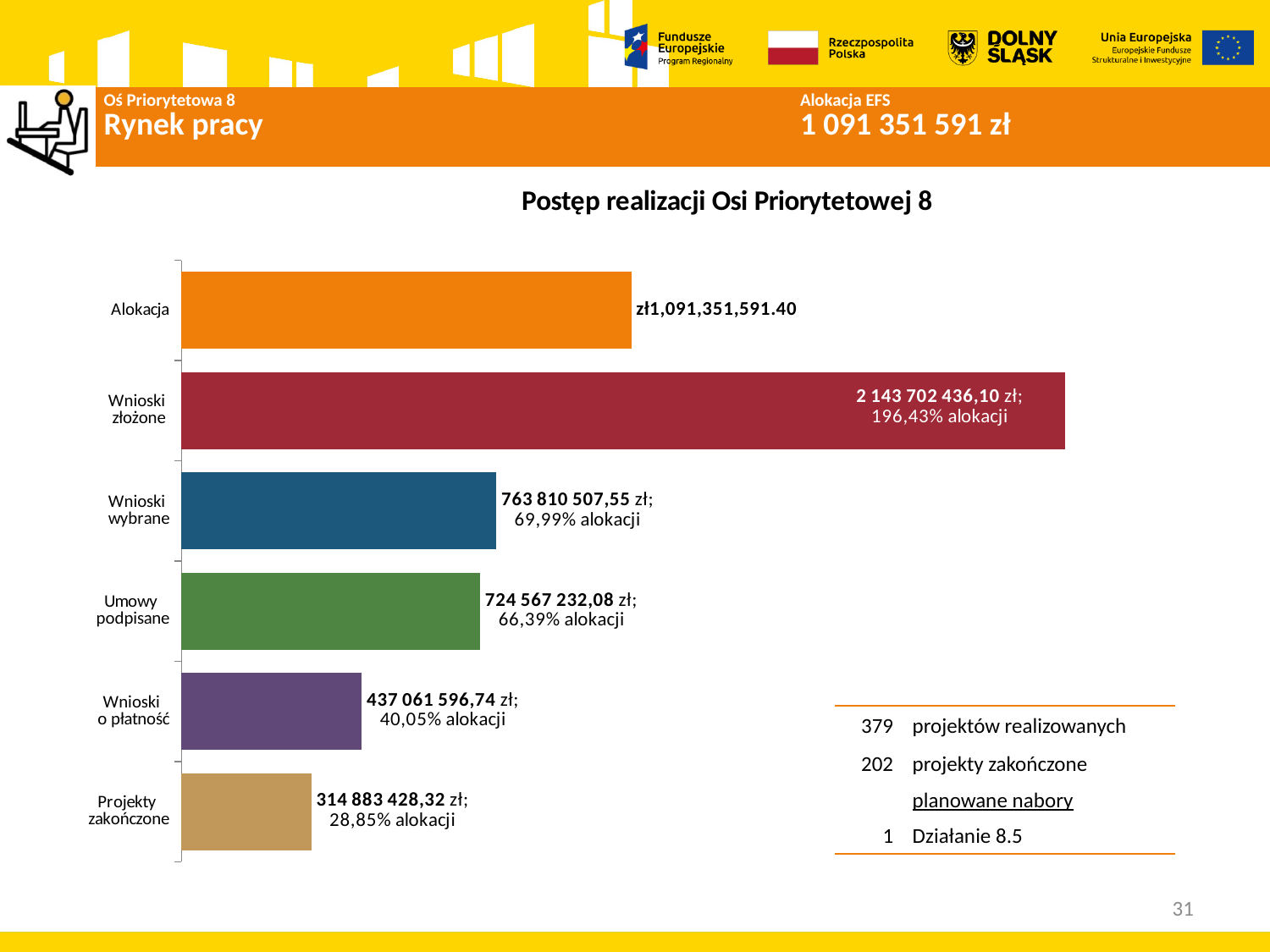
What kind of chart is shown on the slide? bar chart Which is larger, the value for Wnioski wybrane or the value for Umowy podpisane? Wnioski wybrane What is the value shown for Projekty zakończone? 314 883 428,32 zł What percentage of the allocation do Wnioski o płatność represent? 40,05% What is the value shown for Umowy podpisane? 724 567 232,08 zł What is the value shown for Alokacja? zł1,091,351,591.40 Which category has the lowest value in the chart? Projekty zakończone Which category has the highest value in the chart? Wnioski złożone What percentage of the allocation do Wnioski wybrane represent? 69,99% How many categories does the chart show? 6 What is the title of the chart on the slide? Postęp realizacji Osi Priorytetowej 8 What is the value shown for Wnioski złożone? 2 143 702 436,10 zł